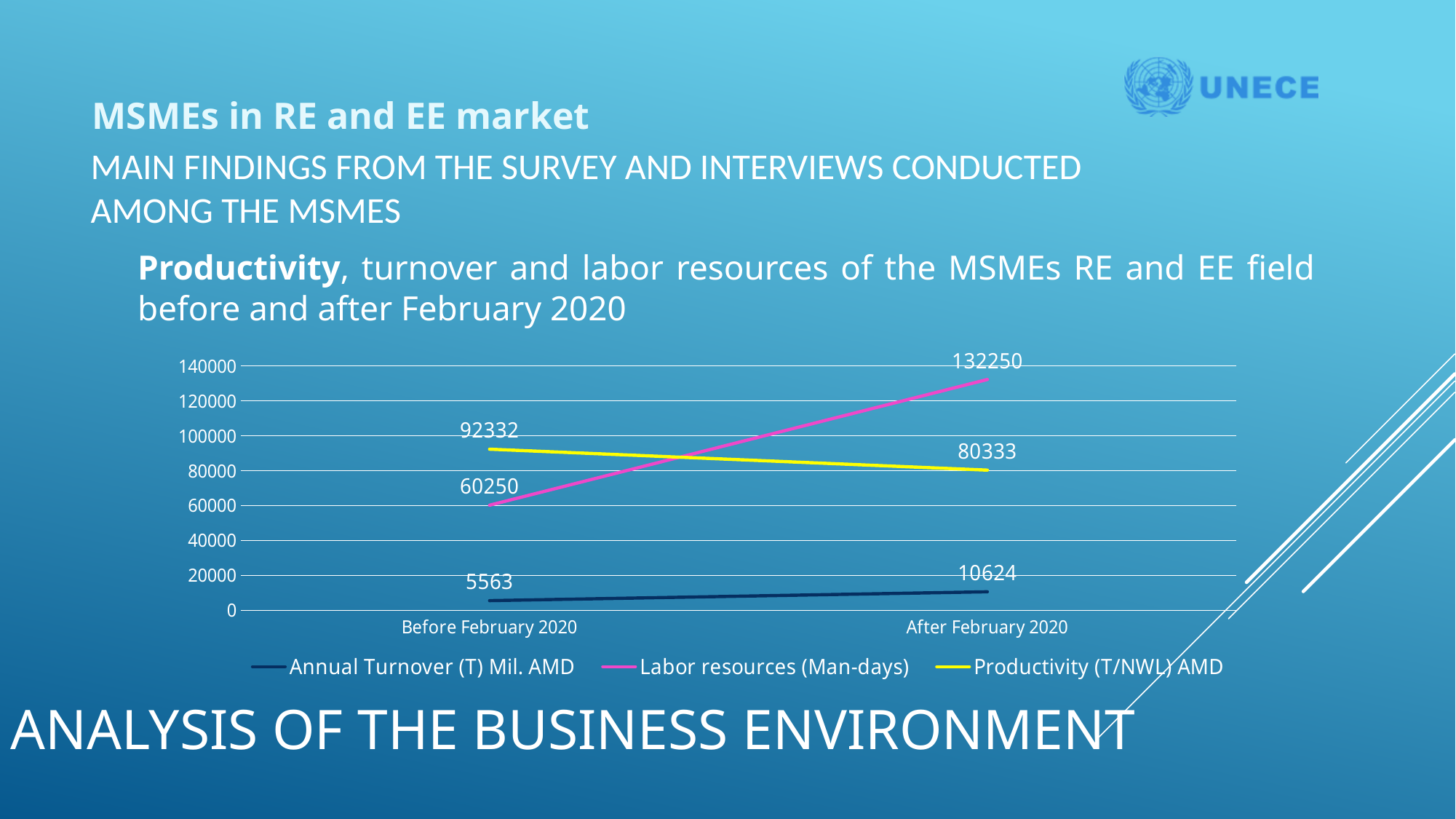
What is the value of Labor resources (Man-days) after February 2020? 132250 What is the value of Productivity (T/NWL) AMD before February 2020? 92332 What kind of chart is shown on the slide? Line chart Does Labor resources (Man-days) rise or fall from before to after February 2020? Rise What is the value of Labor resources (Man-days) before February 2020? 60250 Which series has the highest value after February 2020? Labor resources (Man-days) By how much did Labor resources (Man-days) change from before to after February 2020? 72000 How many categories are shown on the x axis of the chart? 2 How many series does the chart legend list? 3 What is the Annual Turnover (T) Mil. AMD after February 2020? 10624 Does Productivity (T/NWL) AMD rise or fall from before to after February 2020? Fall Which is larger before February 2020: Labor resources (Man-days) or Productivity (T/NWL) AMD? Productivity (T/NWL) AMD